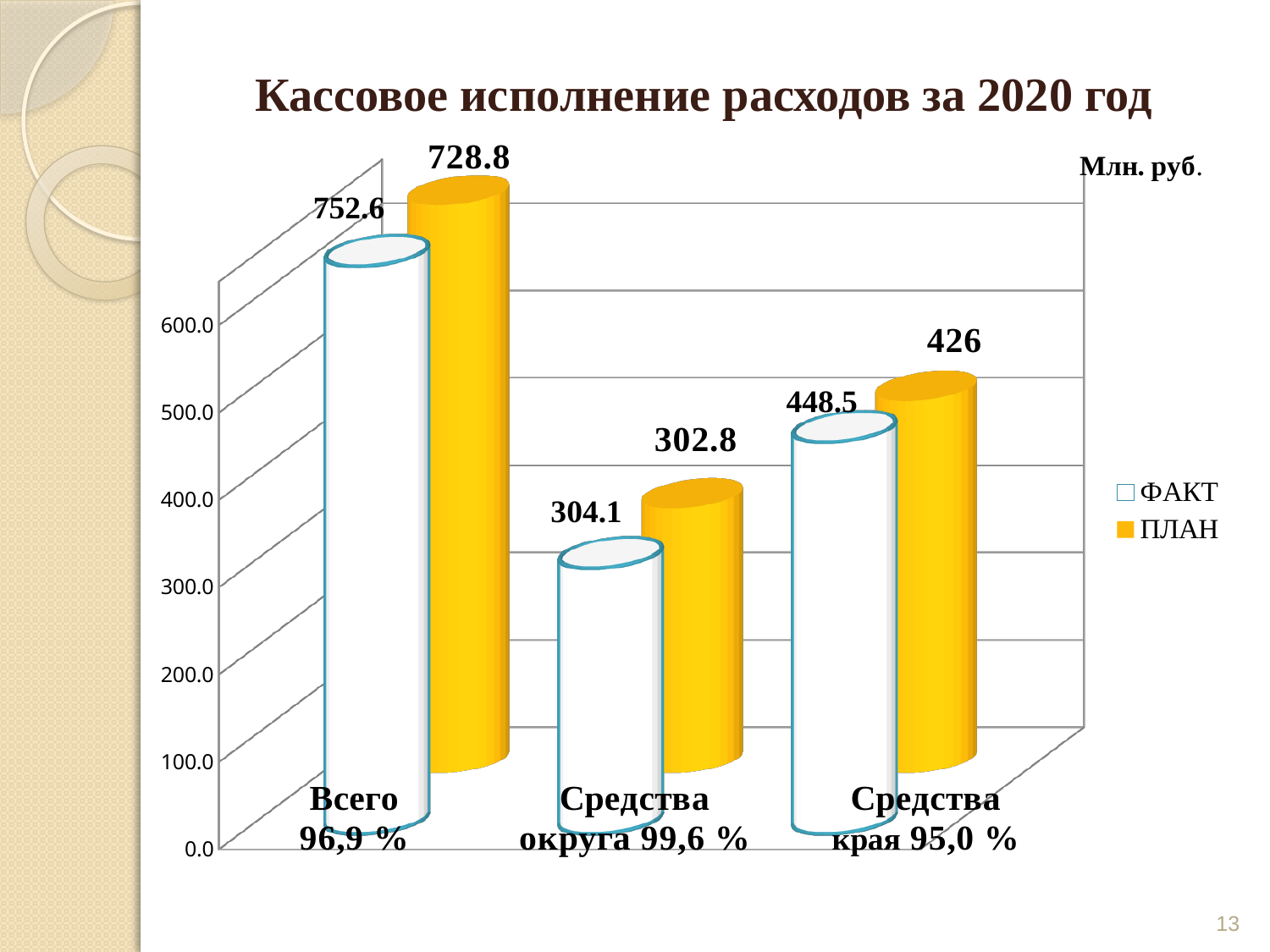
What is the title of the chart? Кассовое исполнение расходов за 2020 год What value is labelled on the ПЛАН bar for Средства округа? 302.8 What value is labelled on the ФАКТ bar for Всего? 752.6 Which category has the lowest labelled values? Средства округа How many categories are shown on the x axis? 3 What is the difference between the two labelled values for Средства края (448.5 and 426)? 22.5 What value is labelled on the ФАКТ bar for Средства края? 448.5 What is the difference between the two labelled values for Всего (752.6 and 728.8)? 23.8 How many series does the legend list? 2 What kind of chart is shown on the slide? bar chart Which two series are listed in the legend? ФАКТ and ПЛАН What value is labelled on the ПЛАН bar for Всего? 728.8